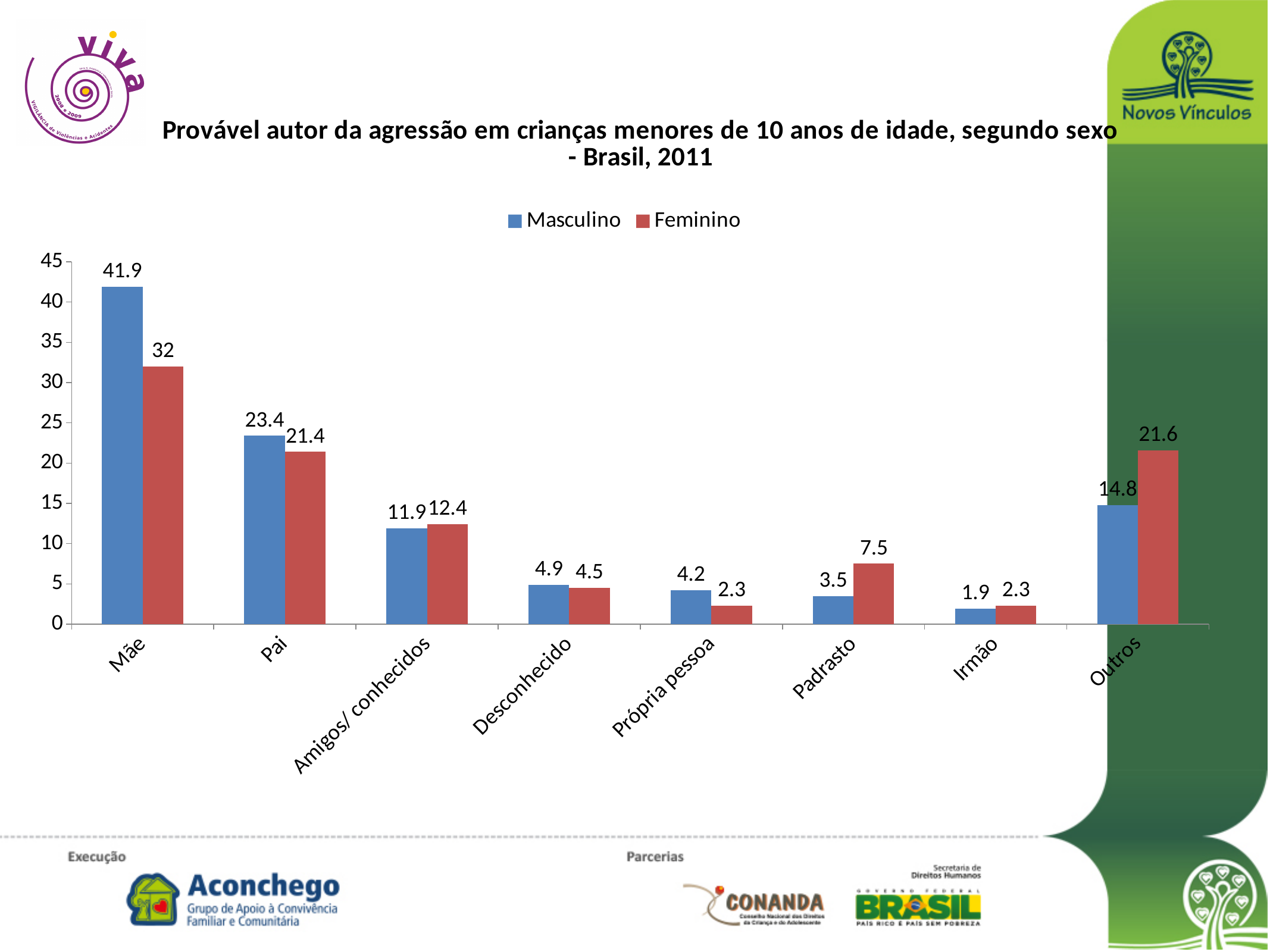
Which colour represents the Feminino series? Red What is the Masculino value for Mãe? 41.9 Is the Masculino value for Pai greater or less than 20? greater Which category has the highest Masculino value? Mãe What is the difference between the Masculino and Feminino values for Mãe? 9.9 How many series does the legend list? 2 Which category has the lowest Masculino value? Irmão What is the Feminino value for Outros? 21.6 Which is larger for Outros, the Masculino value or the Feminino value? Feminino How many categories are shown on the x axis? 8 What kind of chart is shown on the slide? Bar chart What is the Feminino value for Padrasto? 7.5